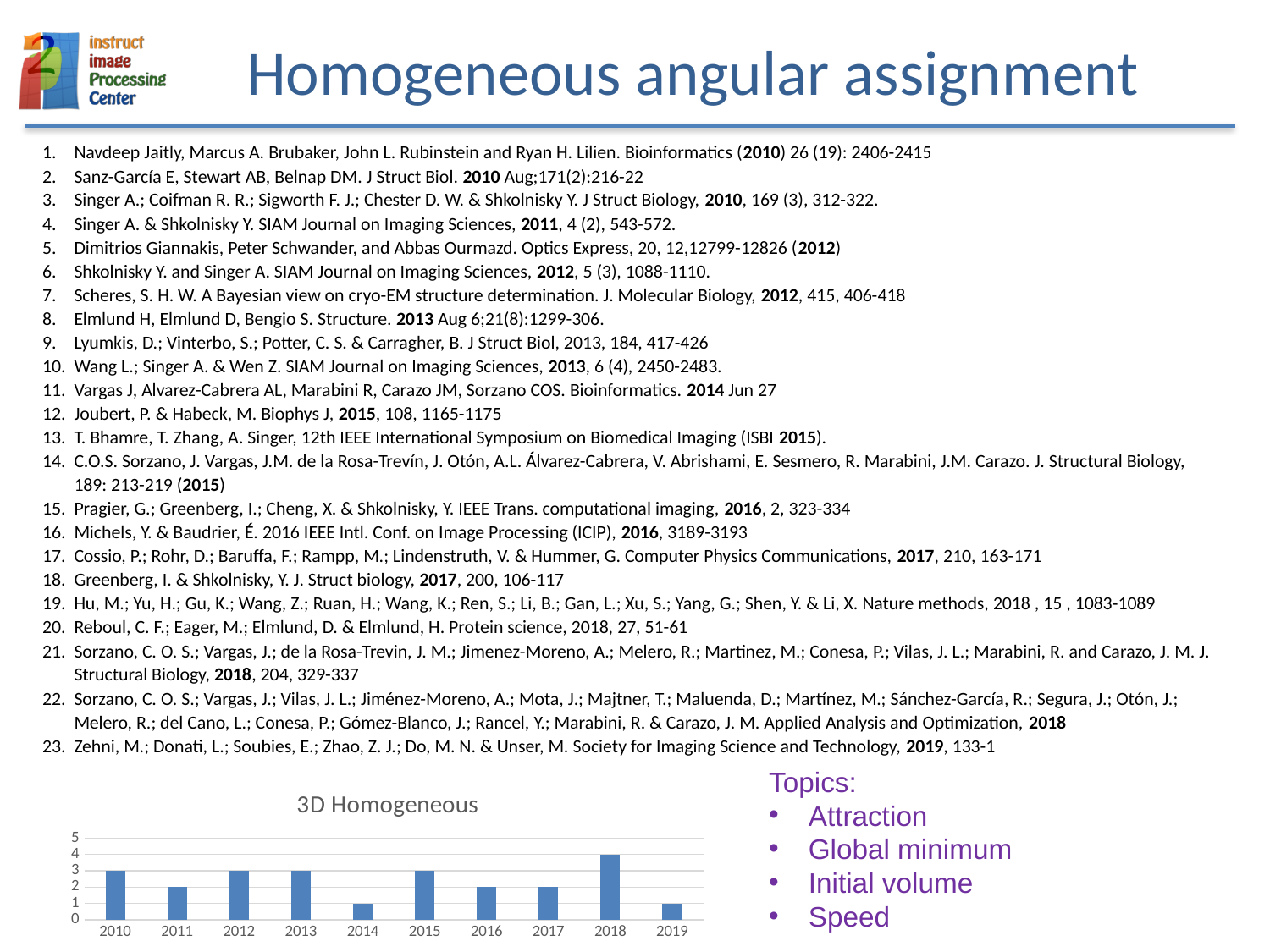
What is the title of the chart on the slide? 3D Homogeneous Which is larger in the 3D Homogeneous chart, the value for 2015 or the value for 2016? 2015 What is the value for 2010 in the 3D Homogeneous chart? 3 How many years are shown on the x axis of the 3D Homogeneous chart? 10 What is the value for 2018 in the 3D Homogeneous chart? 4 Which year has the highest bar in the 3D Homogeneous chart? 2018 What is the difference between the values for 2018 and 2019 in the 3D Homogeneous chart? 3 What is the value for 2011 in the 3D Homogeneous chart? 2 What kind of chart is shown on the slide? bar chart What is the value for 2014 in the 3D Homogeneous chart? 1 Is the value for 2018 in the 3D Homogeneous chart greater or less than 3? greater What is the maximum value shown on the y axis of the 3D Homogeneous chart? 5